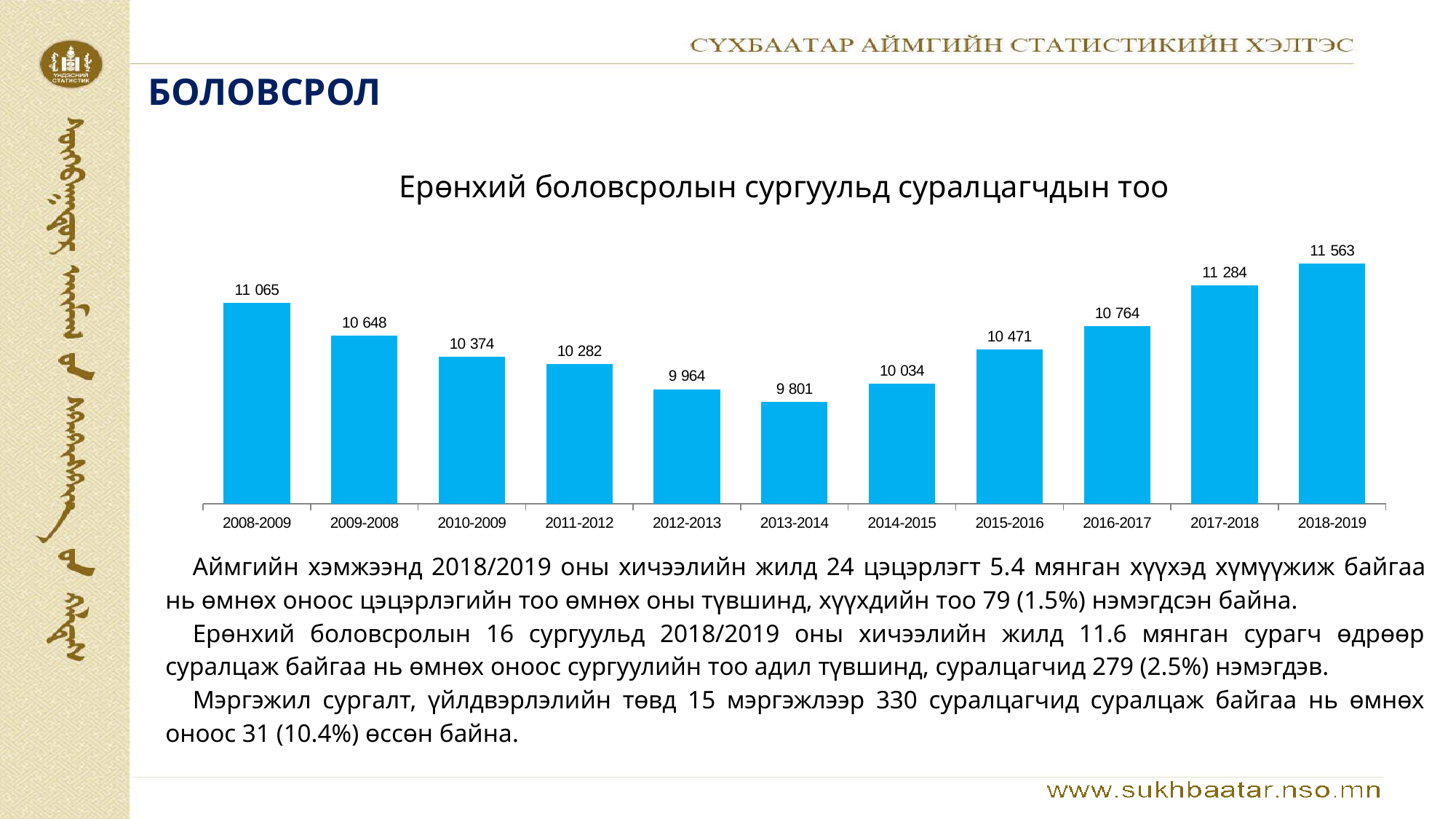
What is the difference between the values for 2018-2019 and 2017-2018? 279 What is the value for 2008-2009? 11 065 What is the difference between the values for 2008-2009 and 2013-2014? 1 264 How many categories are shown on the x axis? 11 Which category has the highest value? 2018-2019 What is the value for 2018-2019? 11 563 What is the title of the chart? Ерөнхий боловсролын сургуульд суралцагчдын тоо Which is larger, the value for 2009-2008 or the value for 2016-2017? 2016-2017 Which category has the lowest value? 2013-2014 What is the value for 2013-2014? 9 801 What kind of chart is shown on the slide? Bar chart What is the value for 2012-2013? 9 964